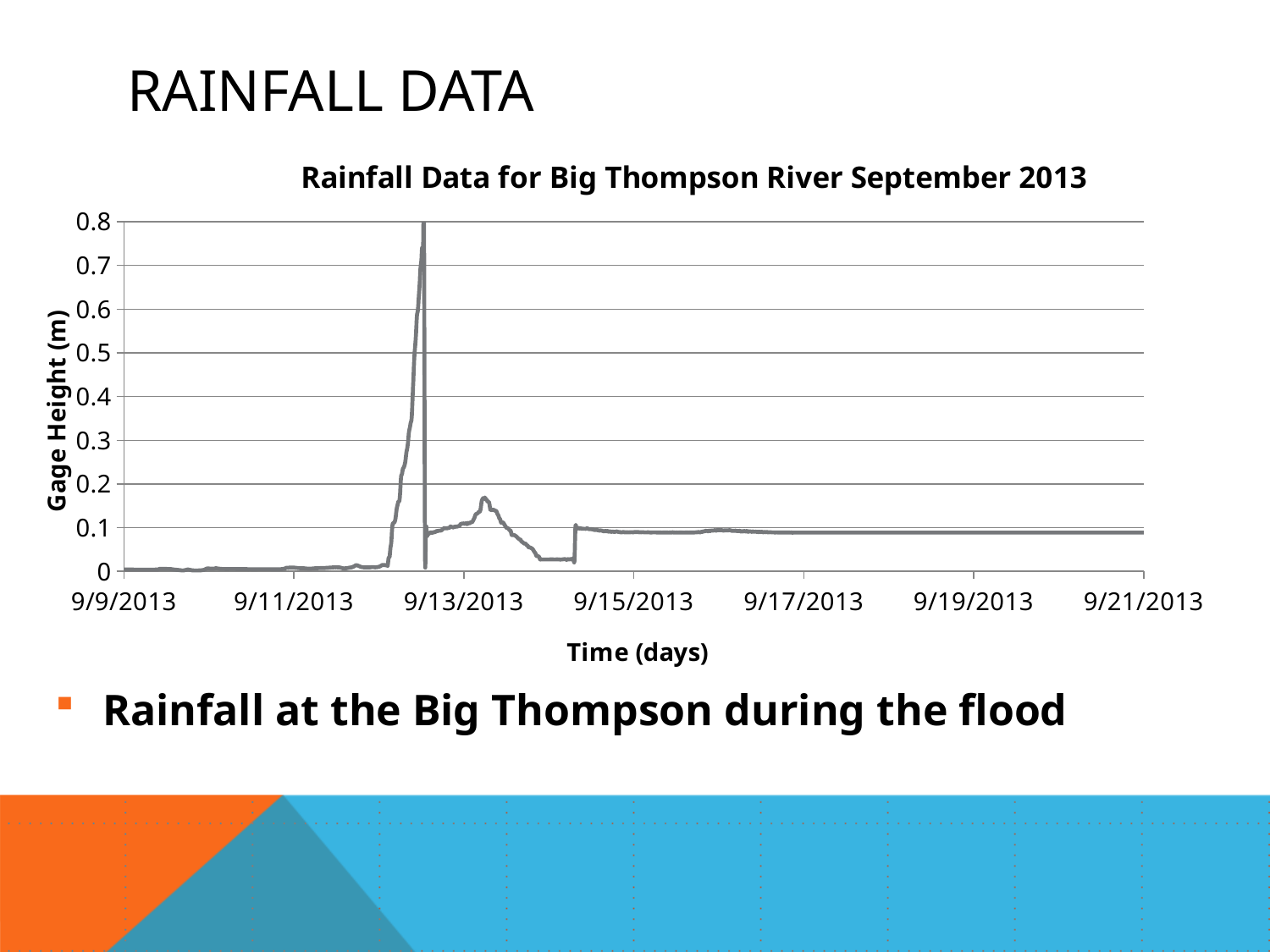
What kind of chart is shown on the slide? line chart Between which two labeled dates on the x axis does the peak gage height occur? 9/11/2013 and 9/13/2013 What is the title of the chart? Rainfall Data for Big Thompson River September 2013 Is the gage height on 9/21/2013 greater or less than 0.2? less Is the highest gage height reached on the chart greater or less than 0.7? greater Which is larger, the gage height on 9/9/2013 or the gage height on 9/17/2013? 9/17/2013 What is the label of the vertical axis? Gage Height (m) Is the gage height on 9/9/2013 greater or less than 0.1? less Does the gage height rise or fall between 9/11/2013 and the peak? rise How many date labels are shown on the x axis? 7